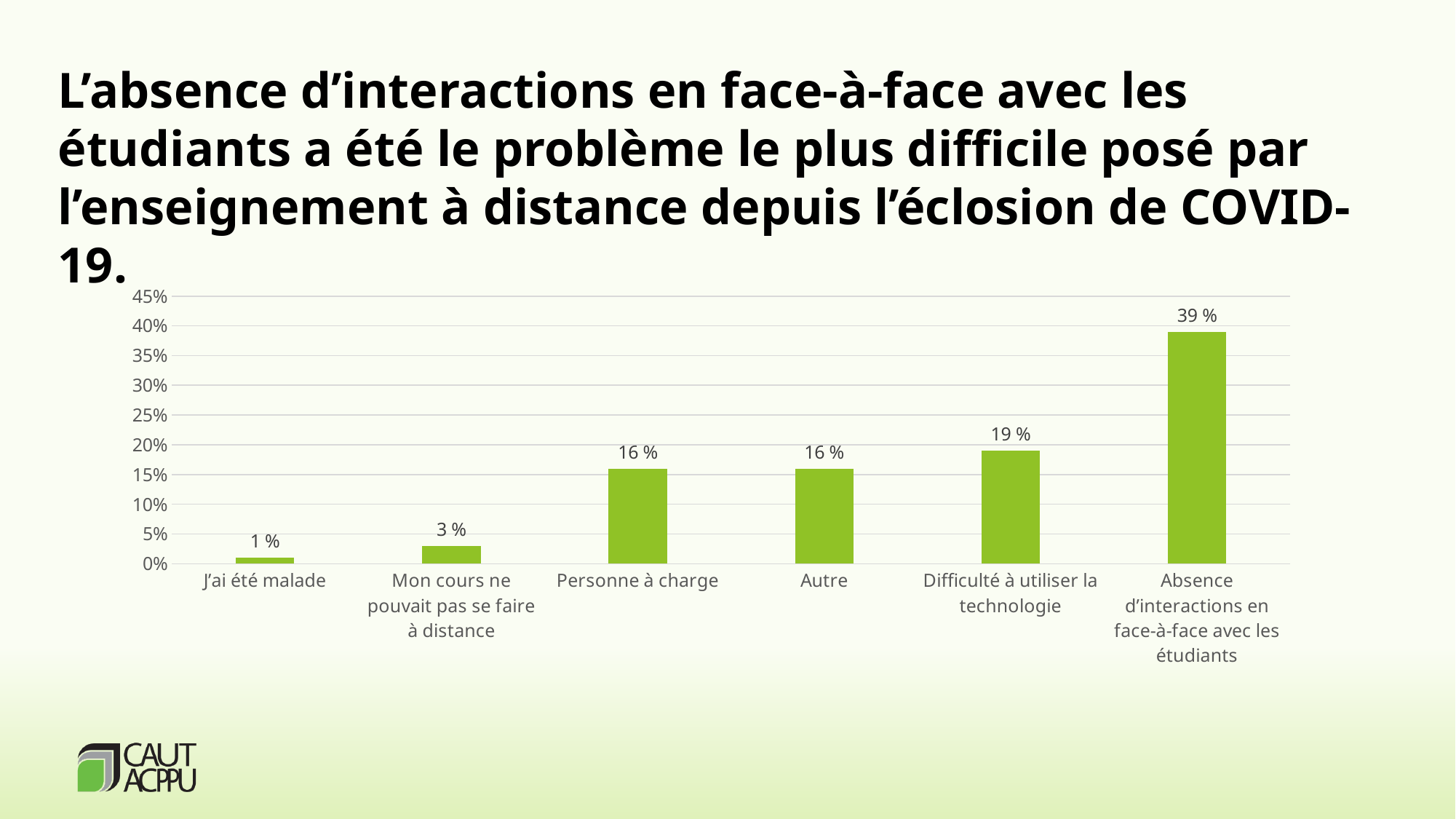
What kind of chart is shown on the slide? bar chart Is the value for "Absence d'interactions en face-à-face avec les étudiants" greater or less than 35%? greater What value is shown for "Difficulté à utiliser la technologie"? 19 % How many categories are shown on the x axis? 6 What is the difference between the values for "Absence d'interactions en face-à-face avec les étudiants" and "Difficulté à utiliser la technologie"? 20 % Which category has the highest value? Absence d'interactions en face-à-face avec les étudiants What is the highest value labelled on the y axis? 45% Which is larger: the value for "Difficulté à utiliser la technologie" or the value for "Autre"? Difficulté à utiliser la technologie Which category has the lowest value? J'ai été malade What value is shown for "Personne à charge"? 16 % What value is shown for "Mon cours ne pouvait pas se faire à distance"? 3 % What value is shown for "Absence d'interactions en face-à-face avec les étudiants"? 39 %